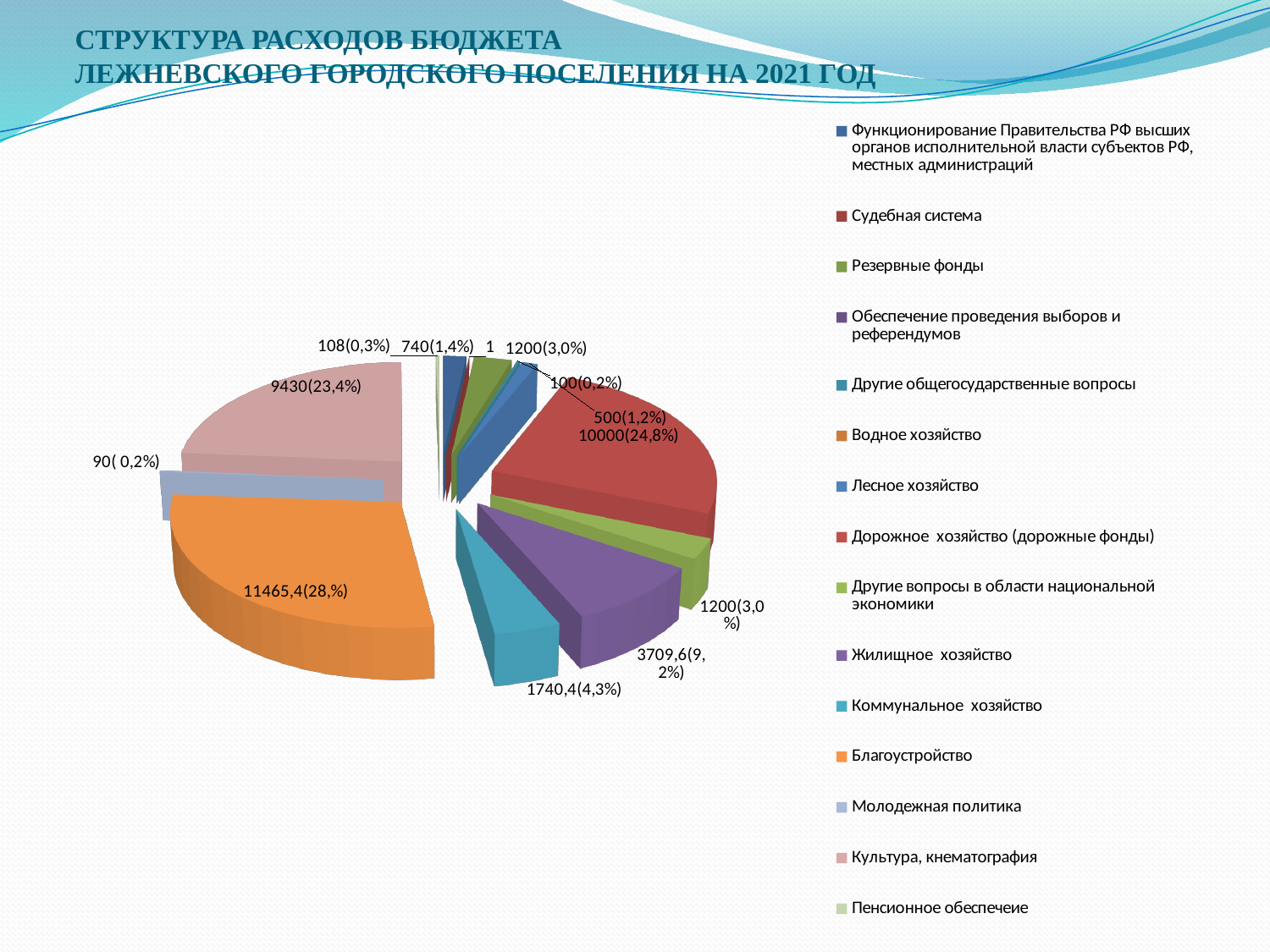
What share of the pie does Дорожное хозяйство (дорожные фонды) take? 24,8% What is the difference between the values for Дорожное хозяйство (дорожные фонды) and Культура, кнематография? 570 How many categories does the legend of the pie chart list? 15 Which category has the largest slice of the pie? Благоустройство What value is labelled for the Благоустройство slice? 11465,4(28,%) What value is labelled for the Дорожное хозяйство (дорожные фонды) slice? 10000(24,8%) What value is labelled for the Жилищное хозяйство slice? 3709,6(9,2%) What kind of chart is shown on the slide? pie chart Which is larger: Дорожное хозяйство (дорожные фонды) or Культура, кнематография? Дорожное хозяйство (дорожные фонды) What value is labelled for the Коммунальное хозяйство slice? 1740,4(4,3%) What value is labelled for the Культура, кнематография slice? 9430(23,4%) What is the title of the slide? СТРУКТУРА РАСХОДОВ БЮДЖЕТА ЛЕЖНЕВСКОГО ГОРОДСКОГО ПОСЕЛЕНИЯ НА 2021 ГОД